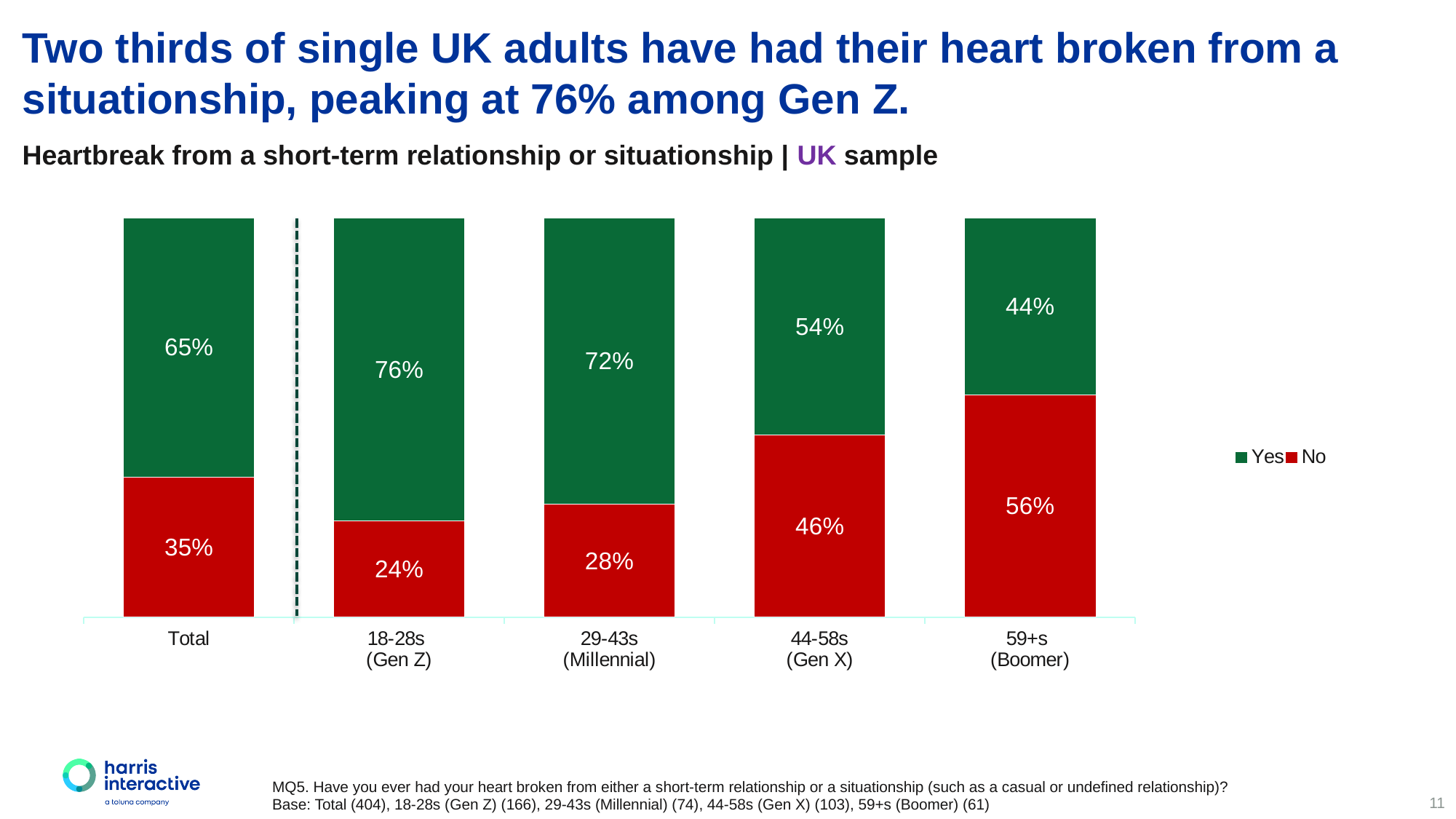
What is the Yes value for the 59+s (Boomer) group? 44% How many series does the legend list? 2 Which is larger: the No value for 59+s (Boomer) or the No value for 44-58s (Gen X)? 59+s (Boomer) Which age group has the highest Yes value? 18-28s (Gen Z) How many categories are shown on the x axis? 5 What percentage of the Total group answered Yes? 65% What kind of chart is shown on the slide? Stacked bar chart What is the No value for the 44-58s (Gen X) group? 46% Which age group has the lowest Yes value? 59+s (Boomer) What is the difference between the Yes values for 18-28s (Gen Z) and 29-43s (Millennial)? 4% Which colour represents the No series in the chart? Red Do the Yes values rise or fall moving from 18-28s (Gen Z) to 59+s (Boomer)? Fall